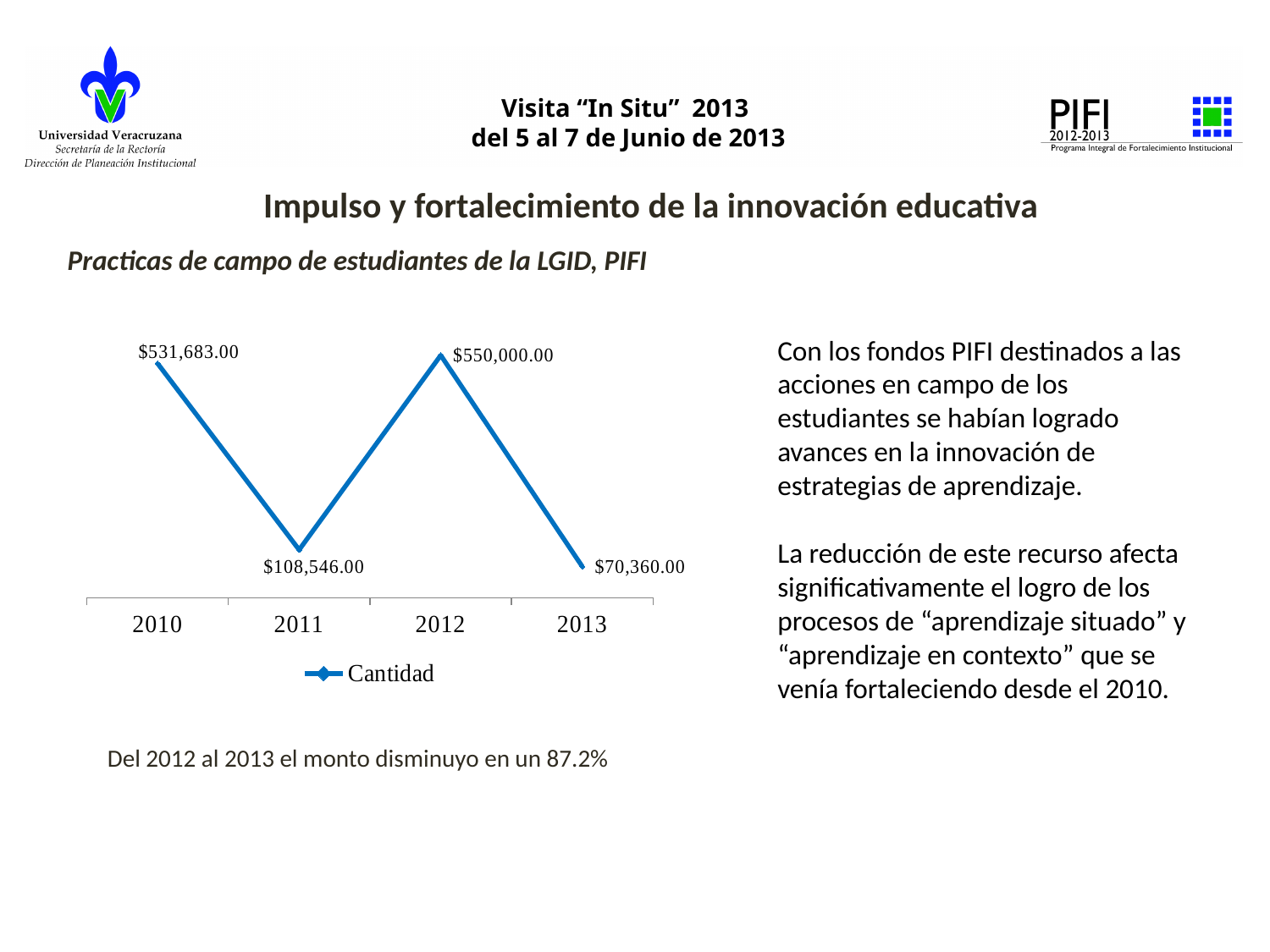
What series name does the legend show? Cantidad What is the value for 2012? $550,000.00 What is the value for 2011? $108,546.00 What is the value for 2010? $531,683.00 What is the value for 2013? $70,360.00 What kind of chart is shown? Line chart Which year has the highest value? 2012 What is the difference between the values for 2012 and 2013? $479,640.00 How many years are plotted on the chart? 4 What is the difference between the values for 2010 and 2011? $423,137.00 Which year has the lowest value? 2013 Which is larger, the value for 2010 or the value for 2012? 2012